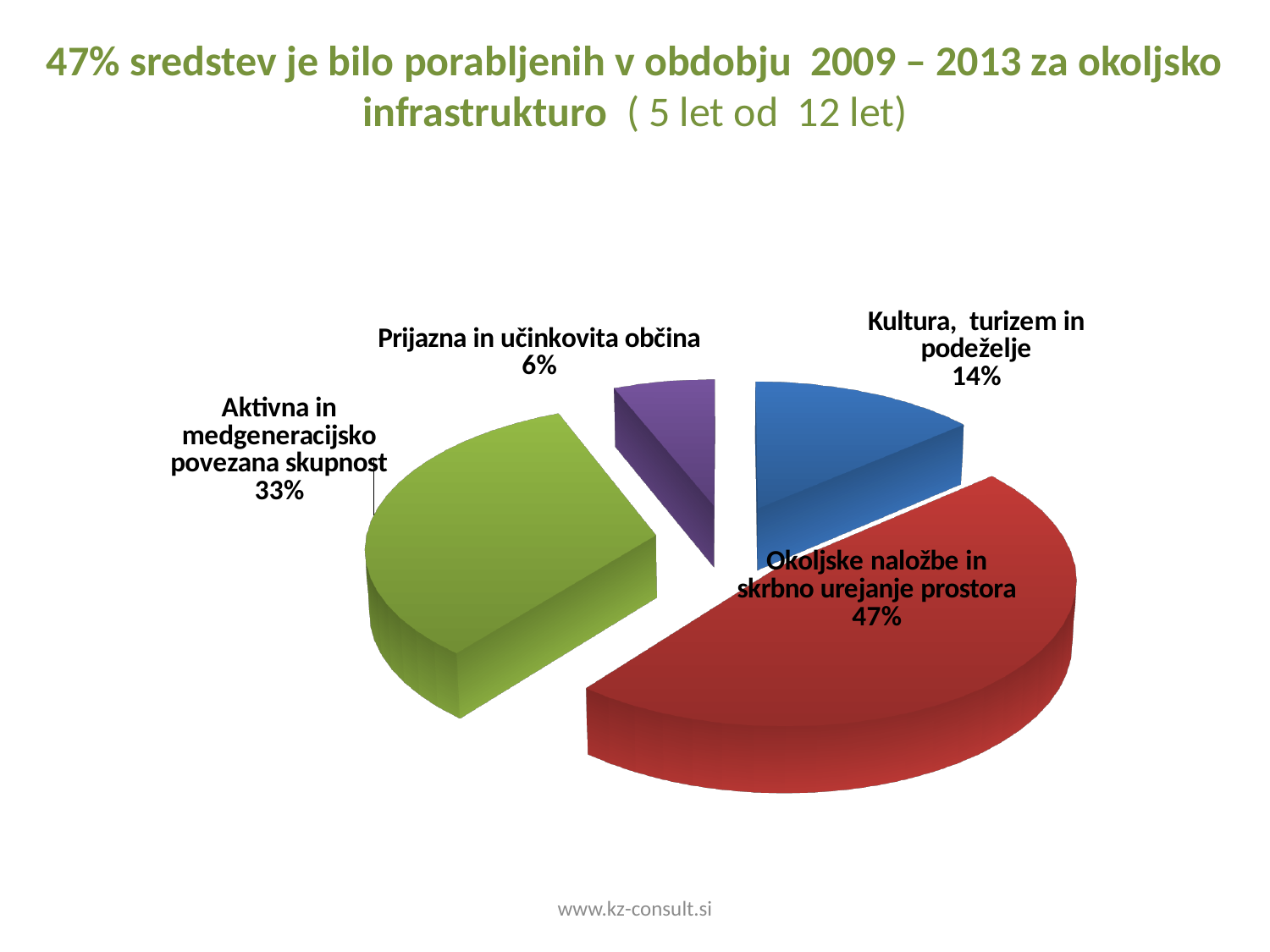
What is the difference in percentage points between 'Kultura, turizem in podeželje' and 'Prijazna in učinkovita občina'? 8 percentage points What share of the pie does 'Prijazna in učinkovita občina' have? 6% What kind of chart is shown on the slide? pie chart What share of the pie does 'Aktivna in medgeneracijsko povezana skupnost' have? 33% Which category has the smallest slice of the pie? Prijazna in učinkovita občina What is the difference in percentage points between 'Okoljske naložbe in skrbno urejanje prostora' and 'Aktivna in medgeneracijsko povezana skupnost'? 14 percentage points Which is larger: the share for 'Kultura, turizem in podeželje' or the share for 'Prijazna in učinkovita občina'? Kultura, turizem in podeželje Which category has the largest slice of the pie? Okoljske naložbe in skrbno urejanje prostora What colour is the slice for 'Aktivna in medgeneracijsko povezana skupnost'? green What share of the pie does 'Kultura, turizem in podeželje' have? 14% How many slices does the pie chart have? 4